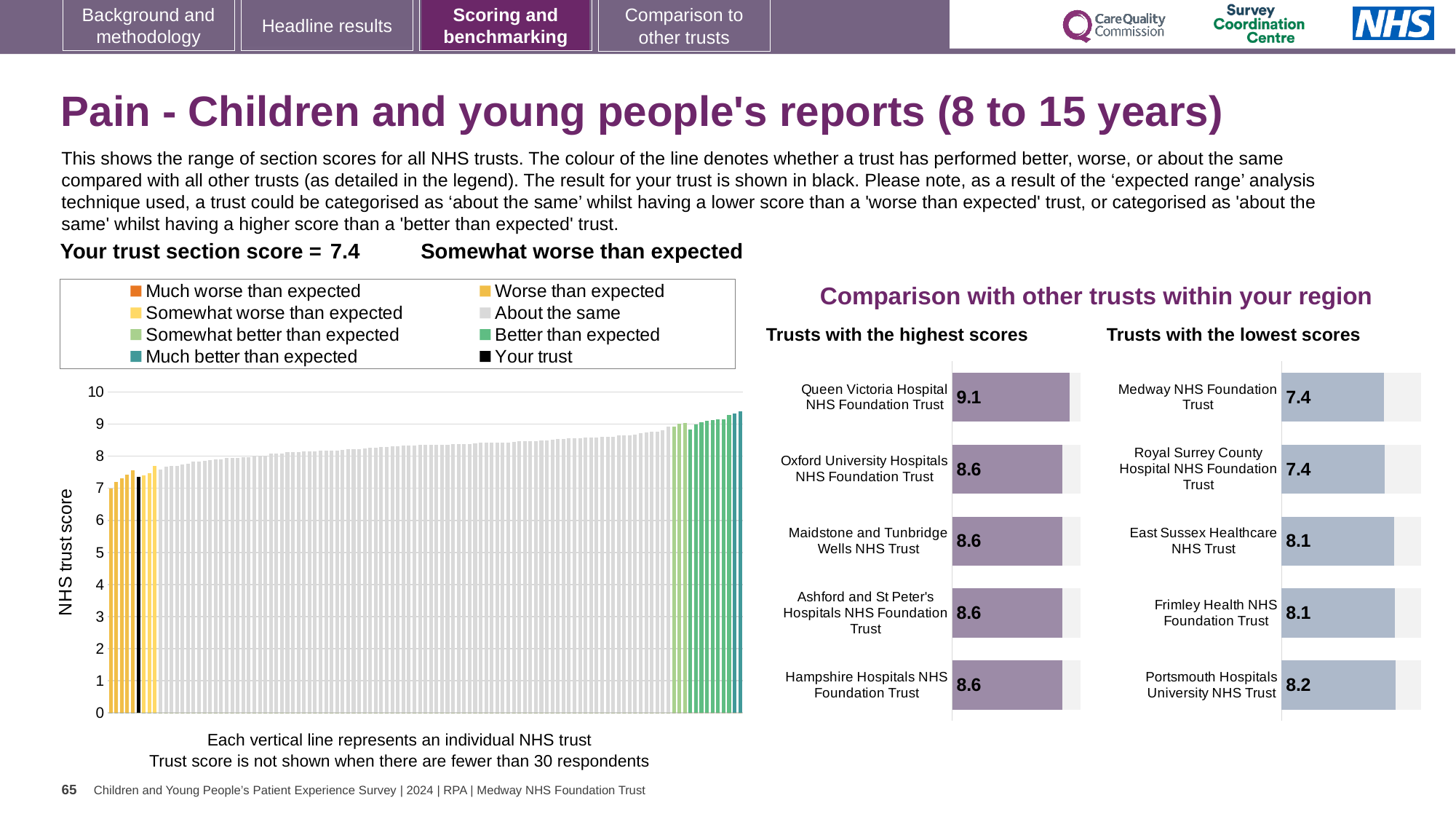
In the 'Trusts with the highest scores' chart, how many trusts are listed? 5 On the large chart on the left, do the trust scores rise or fall from left to right? rise On the large chart on the left, what is the highest value shown on the NHS trust score axis? 10 In the 'Trusts with the lowest scores' chart, what is the difference between the scores of Portsmouth Hospitals University NHS Trust and Medway NHS Foundation Trust? 0.8 In the 'Trusts with the highest scores' chart, which trust has the highest score? Queen Victoria Hospital NHS Foundation Trust What is the section score for your trust shown on the slide? 7.4 In the 'Trusts with the lowest scores' chart, which trust has the highest score? Portsmouth Hospitals University NHS Trust In the 'Trusts with the lowest scores' chart, what is the score for Portsmouth Hospitals University NHS Trust? 8.2 How many entries does the legend above the large chart on the left list? 8 In the 'Trusts with the highest scores' chart, what is the score for Queen Victoria Hospital NHS Foundation Trust? 9.1 In the 'Trusts with the highest scores' chart, what is the difference between the scores of Queen Victoria Hospital NHS Foundation Trust and Hampshire Hospitals NHS Foundation Trust? 0.5 What type of chart is the large chart on the left showing NHS trust scores? bar chart